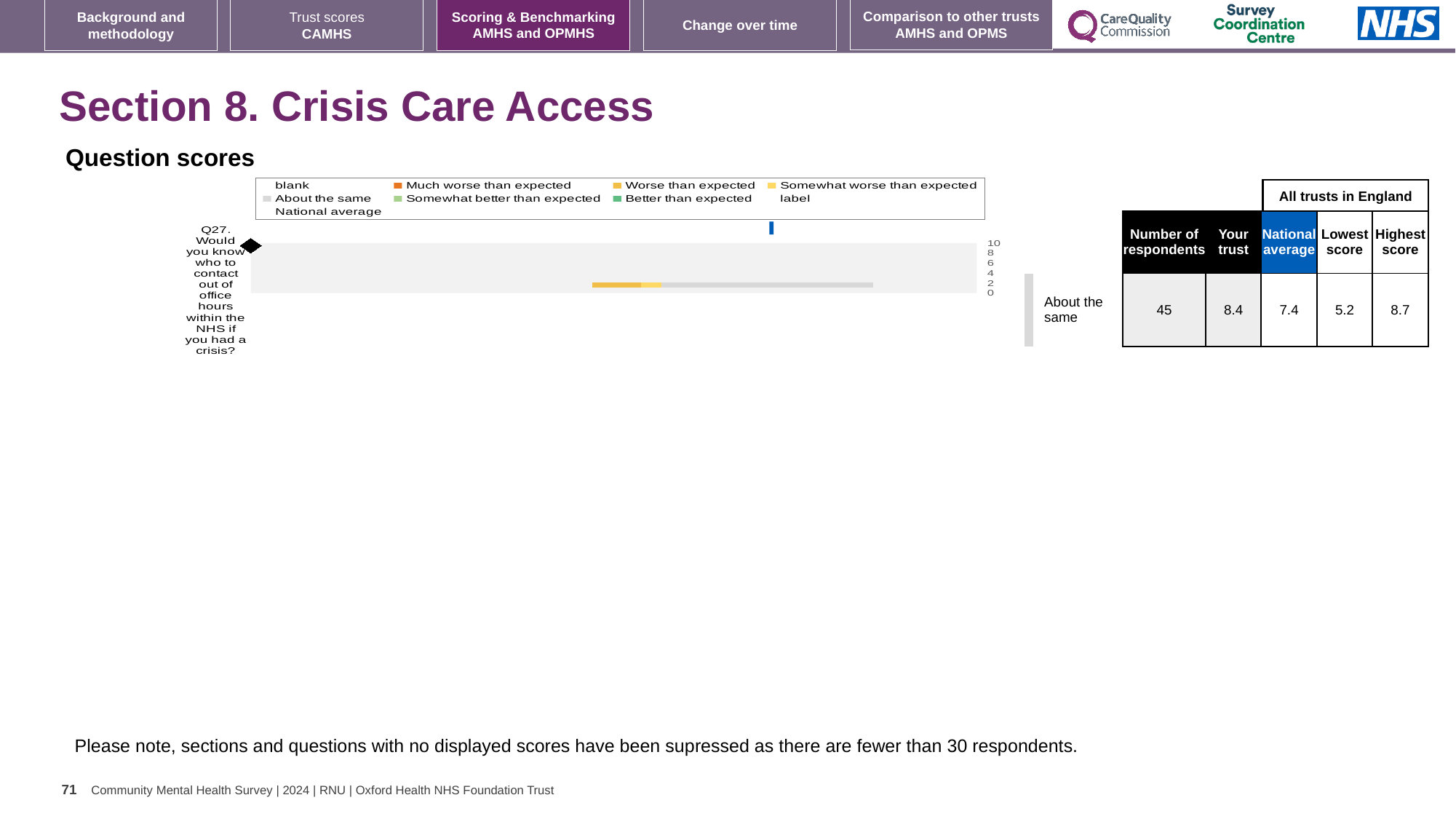
What is the 'Your trust' score for Q27? 8.4 What is the lowest score among all trusts in England for Q27? 5.2 How many questions are plotted in the Question scores chart? 1 For Q27, which is higher: the 'Your trust' score or the national average? Your trust What is the maximum value shown on the score axis of the Question scores chart? 10 For Q27, what is the difference between the 'Your trust' score and the national average? 1.0 Which benchmark category is shown for Q27 in the Question scores chart? About the same What is the number of respondents for Q27 in the Question scores table? 45 What type of chart is used to show the Q27 question score in the Crisis Care Access section? bar chart What is the national average score for Q27? 7.4 For Q27, what is the difference between the highest score and the lowest score among all trusts in England? 3.5 What is the highest score among all trusts in England for Q27? 8.7